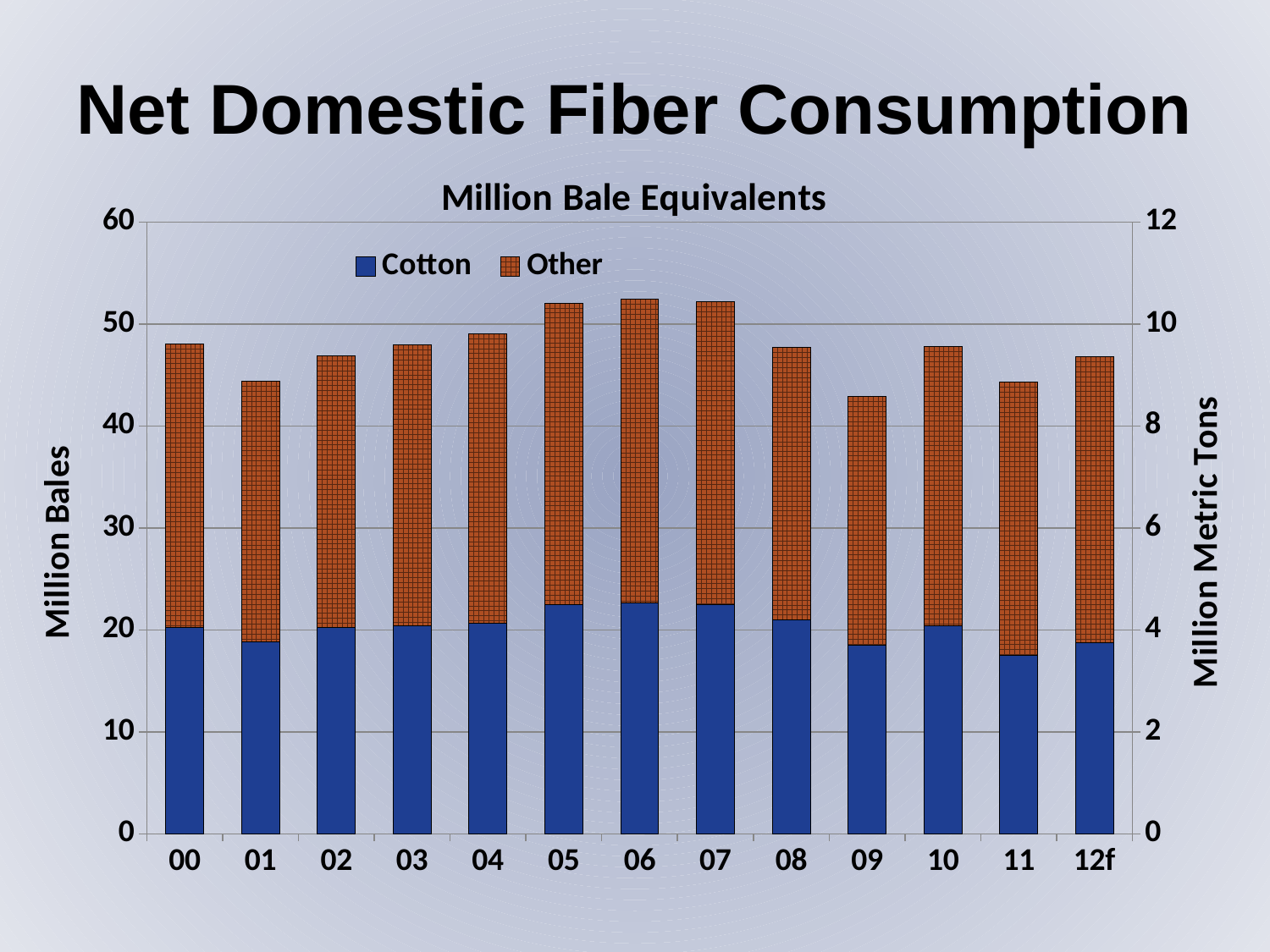
What kind of chart is shown on the slide? Stacked bar chart Is the Cotton value for 11 greater or less than 20 million bales? less Which year has the larger total fiber consumption, 06 or 09? 06 Which year has the lowest total fiber consumption? 09 What are the two series named in the legend? Cotton and Other Which year has the larger Cotton value, 05 or 11? 05 Which year has the lowest Cotton value? 11 Is the total bar for 09 greater or less than 50 million bales? less How many years (categories) are shown along the x axis? 13 Is the total bar for 06 greater or less than 50 million bales? greater What is the label of the right-hand vertical axis? Million Metric Tons How many series does the legend list? 2